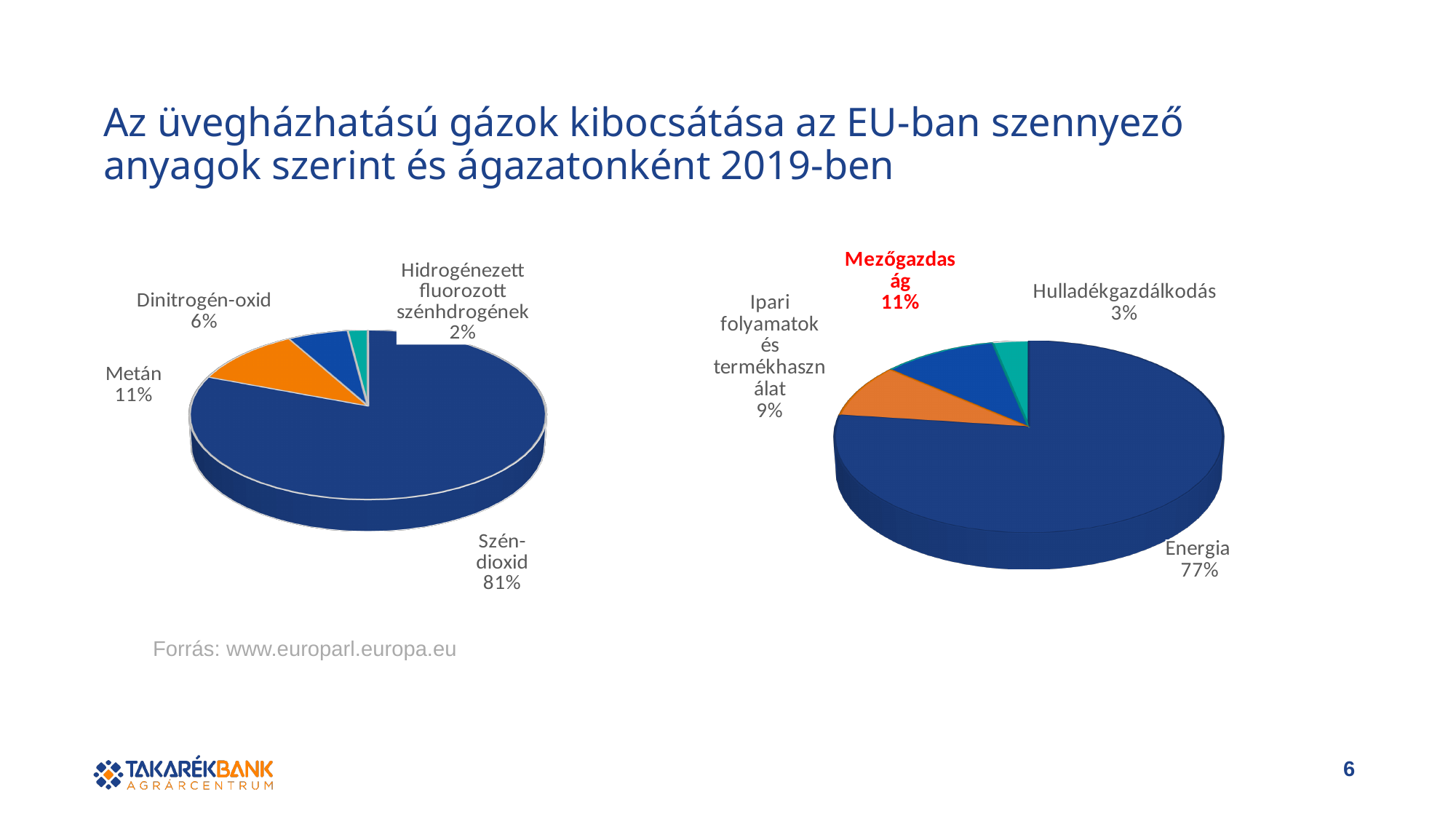
On the right pie chart, which category has the largest share? Energia On the right pie chart, what share does Energia have? 77% On the right pie chart, what share does Mezőgazdaság have? 11% On the left pie chart, how many slices are there? 4 On the left pie chart, what is the difference between the shares of Metán and Dinitrogén-oxid? 5% On the left pie chart, what share does Szén-dioxid have? 81% What type of chart is the right chart? Pie chart On the right pie chart, which is larger: Ipari folyamatok és termékhasználat or Hulladékgazdálkodás? Ipari folyamatok és termékhasználat On the left pie chart, which category has the smallest share? Hidrogénezett fluorozott szénhdrogének On the right pie chart, what is the difference between the shares of Energia and Mezőgazdaság? 66% On the left pie chart, what share does Metán have? 11% On the right pie chart, which category label is highlighted in red? Mezőgazdaság